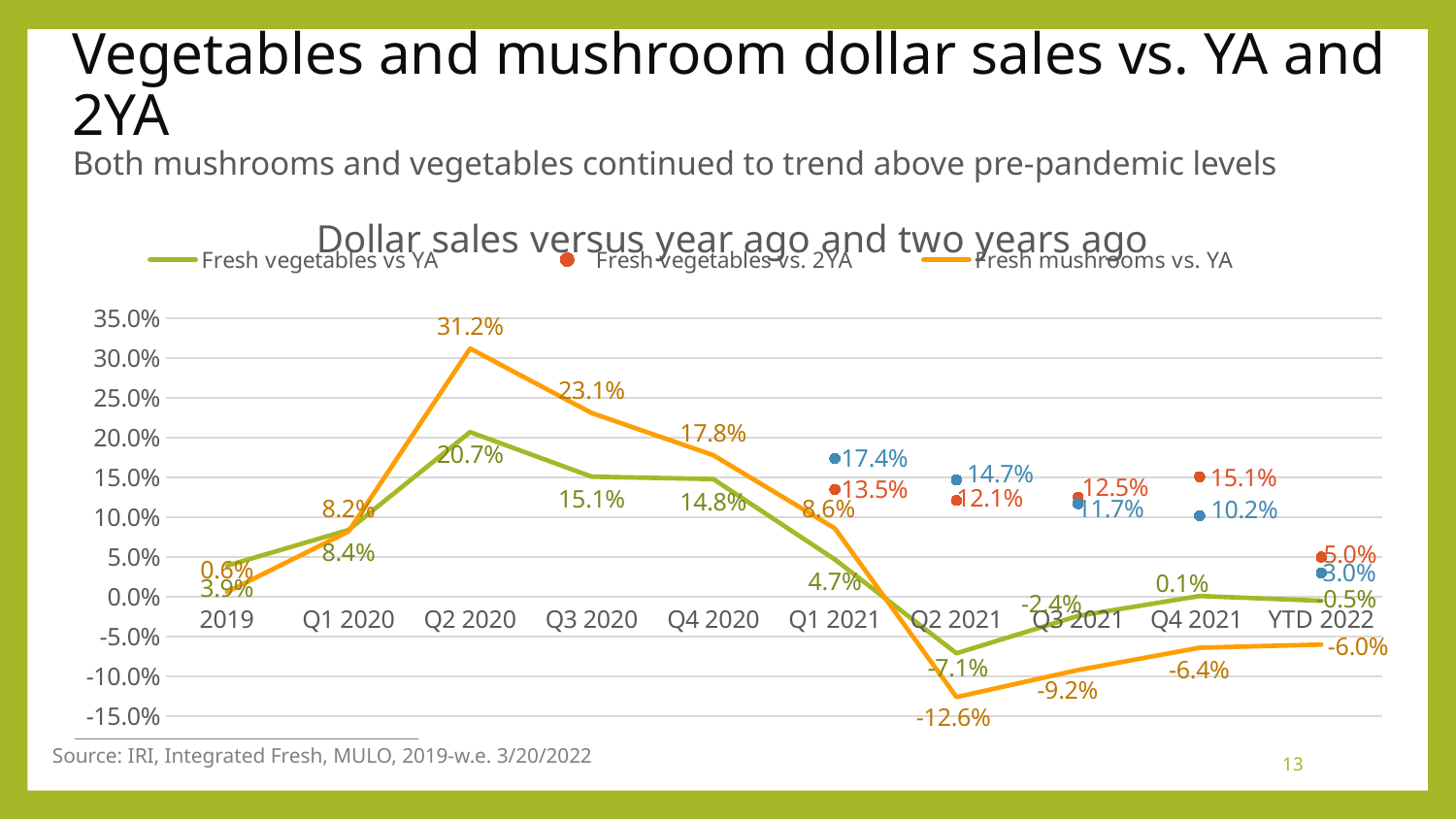
In which period was Fresh vegetables vs YA at its lowest value? Q2 2021 (-7.1%) Did Fresh vegetables vs YA rise or fall from Q2 2020 to Q2 2021? Fall What was the value of Fresh vegetables vs. 2YA in Q4 2021? 15.1% In Q3 2020, which was larger: Fresh mushrooms vs. YA or Fresh vegetables vs YA? Fresh mushrooms vs. YA In which period did Fresh mushrooms vs. YA reach its highest value, and what was it? Q2 2020, 31.2% In Q2 2020, how many percentage points higher was Fresh mushrooms vs. YA than Fresh vegetables vs YA? 10.5 percentage points What was the value of Fresh vegetables vs YA in Q4 2021? 0.1% What kind of chart is shown on the slide? Line chart What was the value of Fresh vegetables vs YA in Q2 2020? 20.7% How many series does the chart legend list? 3 How many time periods are shown along the x axis? 10 In which period was Fresh mushrooms vs. YA at its lowest value? Q2 2021 (-12.6%)